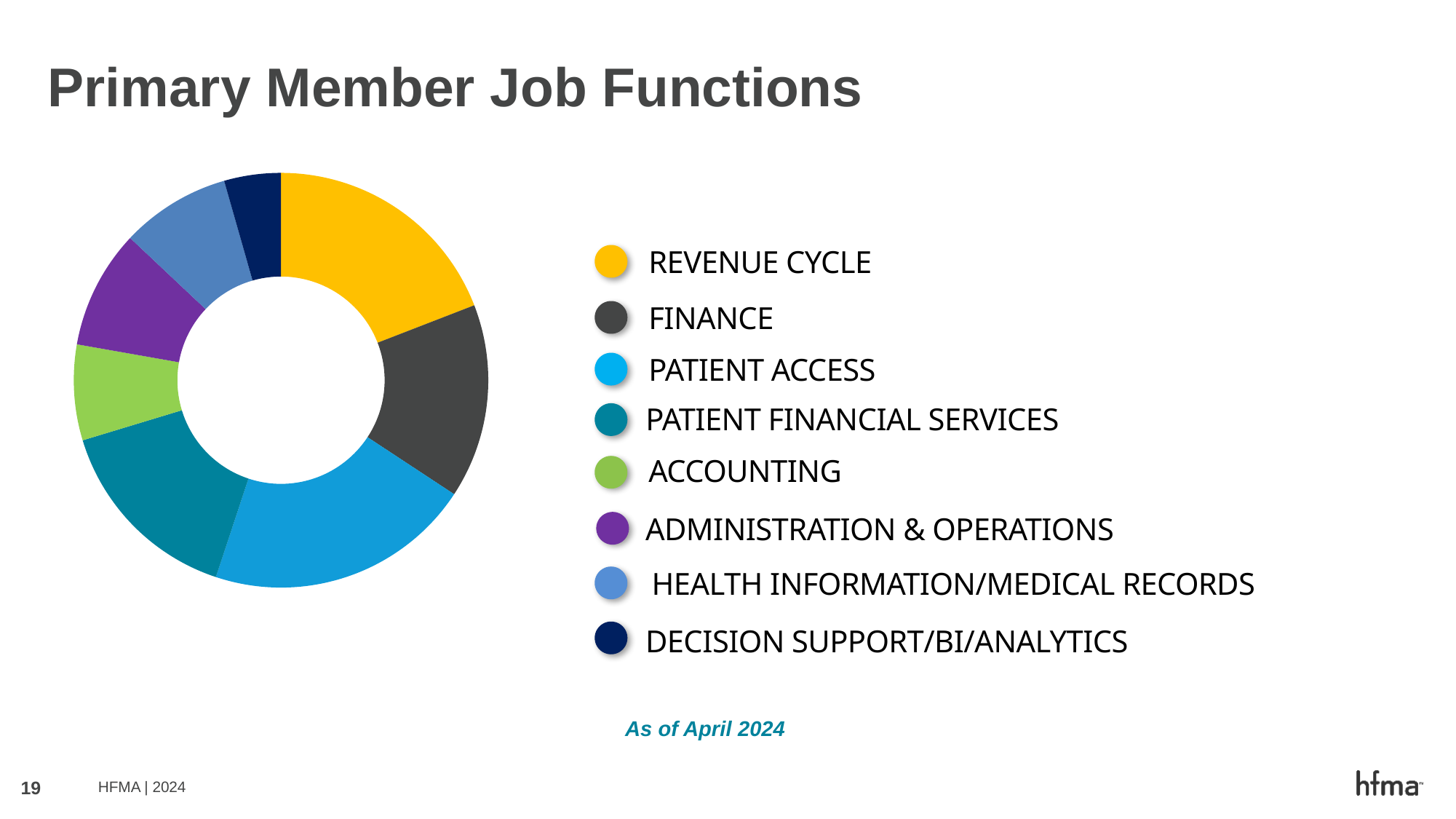
Which slice is larger, Revenue Cycle or Finance? Revenue Cycle Which slice is larger, Finance or Administration & Operations? Finance Which slice is larger, Patient Financial Services or Health Information/Medical Records? Patient Financial Services Which job function has the smallest slice of the chart? Decision Support/BI/Analytics What is the title of the chart on the slide? Primary Member Job Functions Which job function is shown in yellow on the chart? Revenue Cycle How many job function categories does the chart show? 8 What kind of chart is shown on the slide? Pie chart (donut)